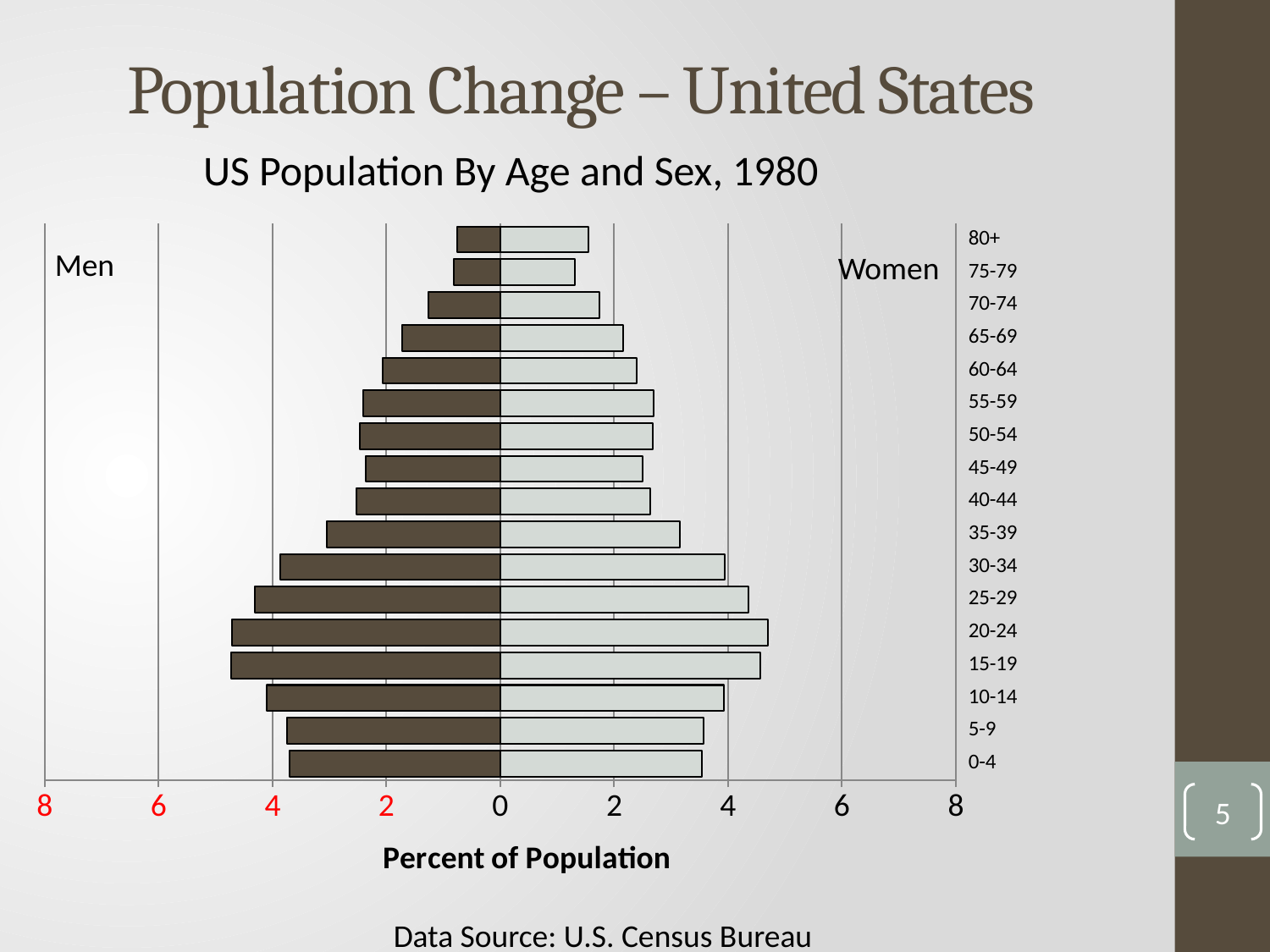
Is the value for Women aged 20-24 greater or less than 4? greater What is the label on the horizontal axis? Percent of Population Is the value for Men aged 20-24 greater or less than 4? greater What kind of chart is shown on the slide? Bar chart Which is larger, the value for Women aged 25-29 or Women aged 45-49? Women aged 25-29 How many groups (series) does the chart show, as labelled on the plot? 2 How many age groups are shown on the chart? 17 Is the value for Men aged 55-59 greater or less than 2? greater Which is larger, the value for Men aged 20-24 or Men aged 80+? Men aged 20-24 What is the title of the chart? US Population By Age and Sex, 1980